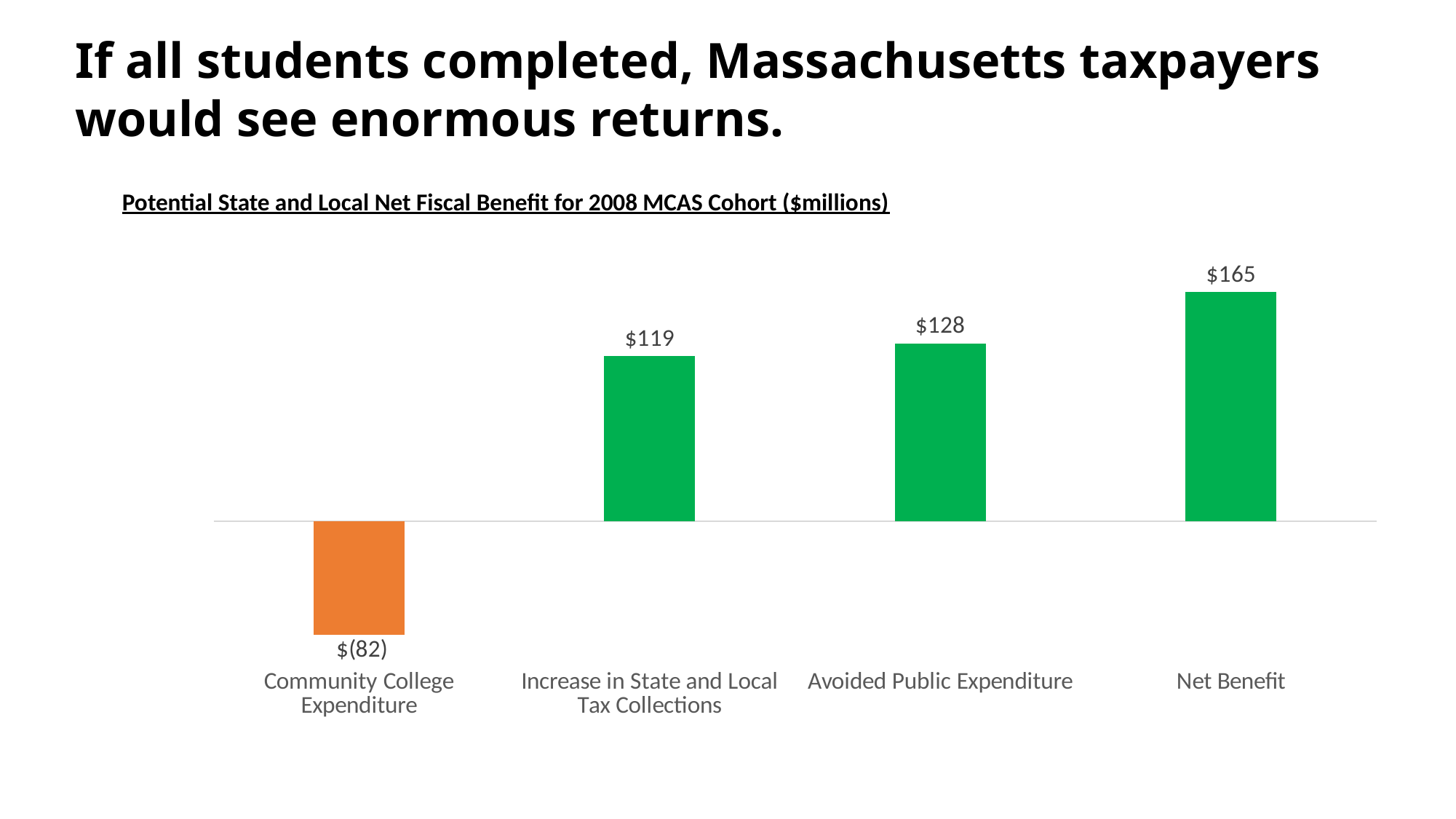
What is the title of the chart? Potential State and Local Net Fiscal Benefit for 2008 MCAS Cohort ($millions) How many categories are shown in the chart? 4 What is the value for Increase in State and Local Tax Collections? $119 What is the value for Community College Expenditure? $(82) What is the difference between Net Benefit and Avoided Public Expenditure? $37 What is the value for Net Benefit? $165 What is the difference between Avoided Public Expenditure and Increase in State and Local Tax Collections? $9 Which category has the highest value? Net Benefit What kind of chart is shown on the slide? Bar chart Which category has the lowest value? Community College Expenditure Which is larger, Increase in State and Local Tax Collections or Avoided Public Expenditure? Avoided Public Expenditure What is the value for Avoided Public Expenditure? $128